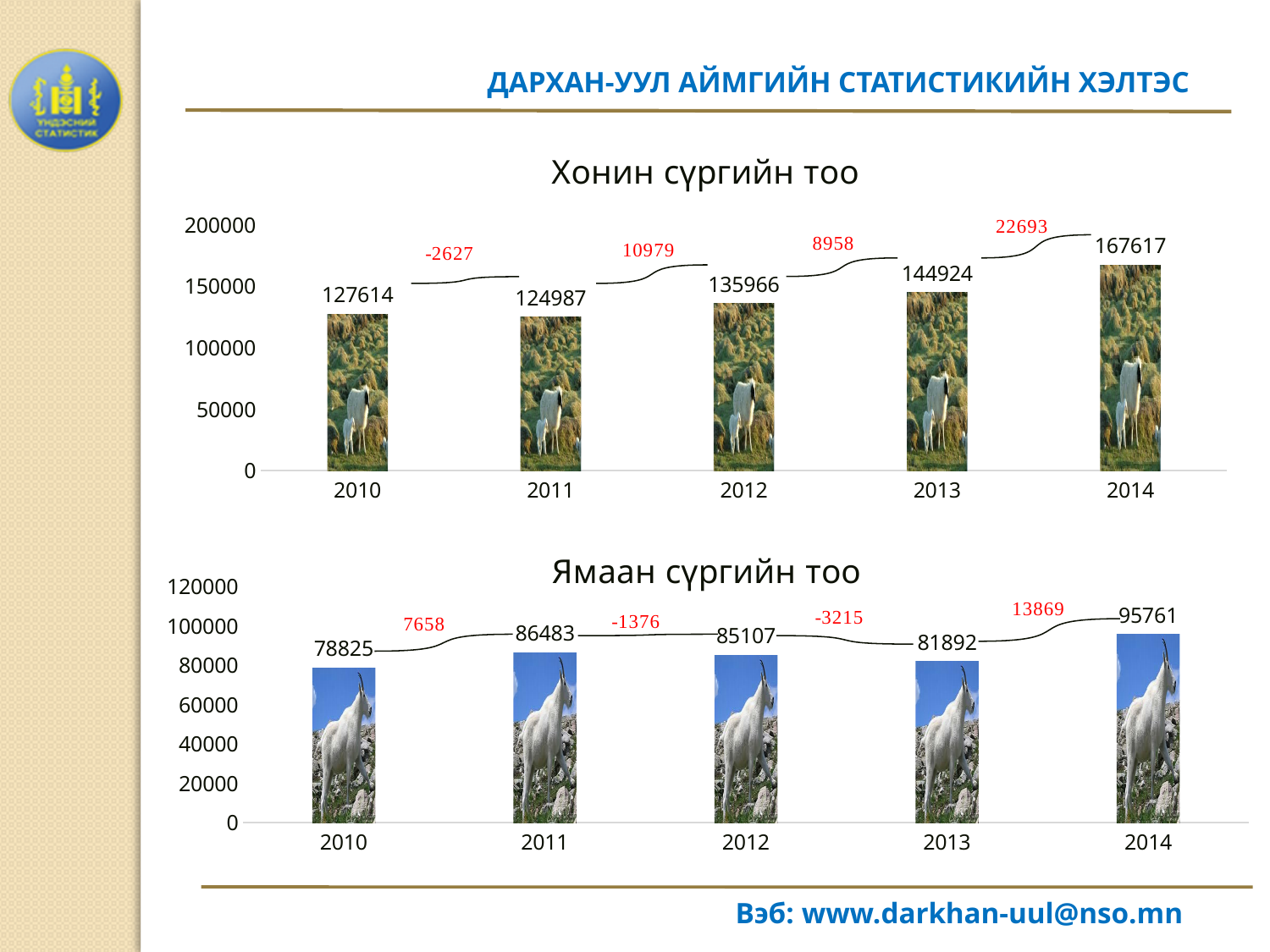
In the chart titled "Ямаан сүргийн тоо", which is larger, the value for 2011 or the value for 2012? 2011 In the chart titled "Хонин сүргийн тоо", how many years are shown on the x axis? 5 In the chart titled "Ямаан сүргийн тоо", what is the difference between the 2011 value and the 2010 value? 7658 In the chart titled "Хонин сүргийн тоо", which year has the highest value? 2014 What kind of chart is the chart titled "Ямаан сүргийн тоо"? bar chart In the chart titled "Ямаан сүргийн тоо", which year has the highest value? 2014 In the chart titled "Хонин сүргийн тоо", what is the value for 2012? 135966 In the chart titled "Хонин сүргийн тоо", which year has the lowest value? 2011 In the chart titled "Ямаан сүргийн тоо", which year has the lowest value? 2010 In the chart titled "Хонин сүргийн тоо", is the value for 2014 greater or less than 150000? greater In the chart titled "Ямаан сүргийн тоо", what is the value for 2013? 81892 In the chart titled "Хонин сүргийн тоо", what is the difference between the 2014 value and the 2013 value? 22693